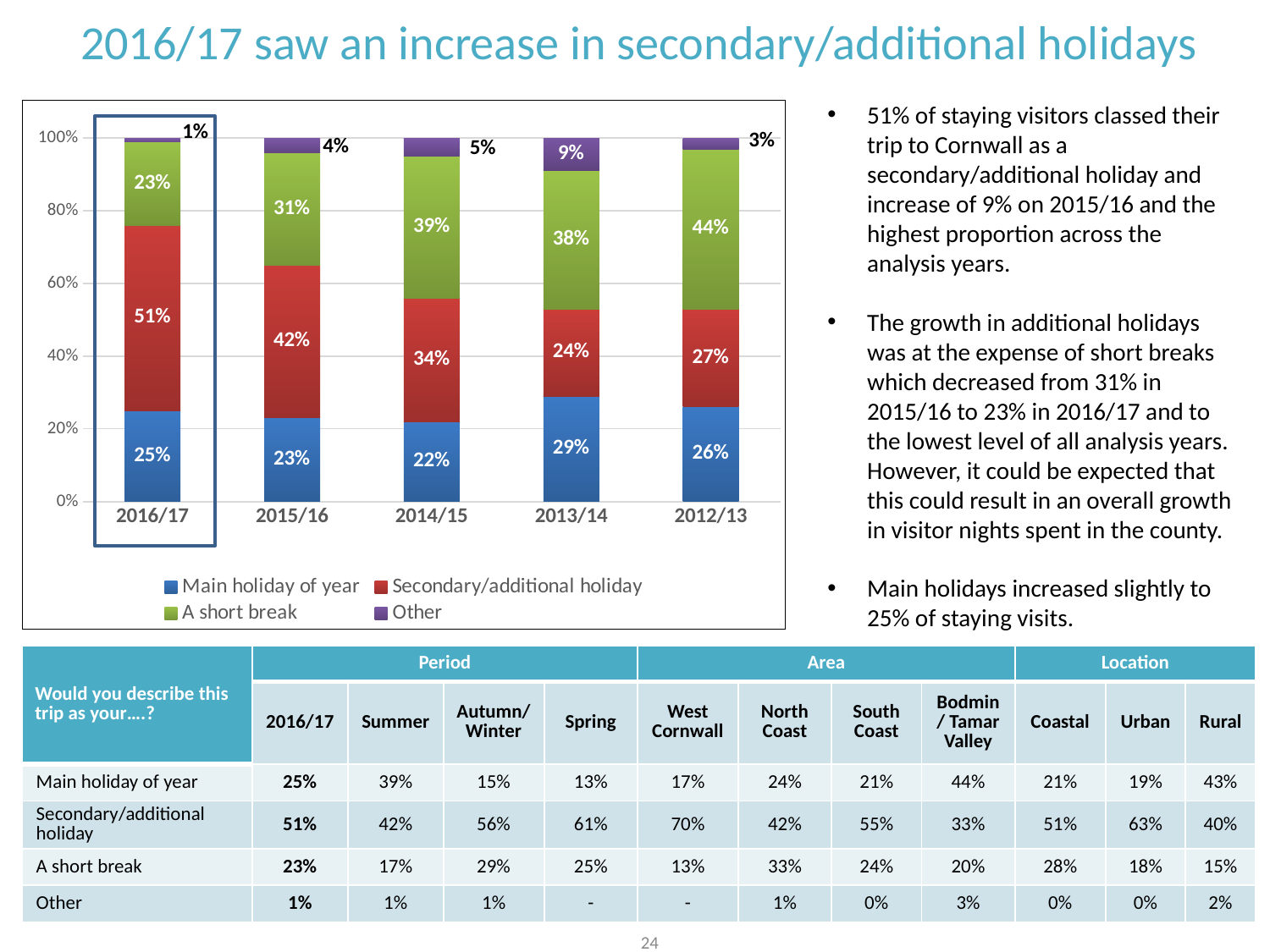
Which is larger: the A short break value in 2012/13 or in 2013/14? 2012/13 What is the value for A short break in 2015/16? 31% How many series does the chart legend list? 4 What is the value for Secondary/additional holiday in 2016/17? 51% In which year is the Secondary/additional holiday share highest? 2016/17 In which year is the A short break share lowest? 2016/17 What is the difference between the Secondary/additional holiday values for 2016/17 and 2015/16? 9% What is the value for Other in 2014/15? 5% Which year on the chart is highlighted with a box outline? 2016/17 What type of chart is shown on the slide? Stacked bar chart What is the value for Main holiday of year in 2013/14? 29% How many years are shown on the x axis of the chart? 5